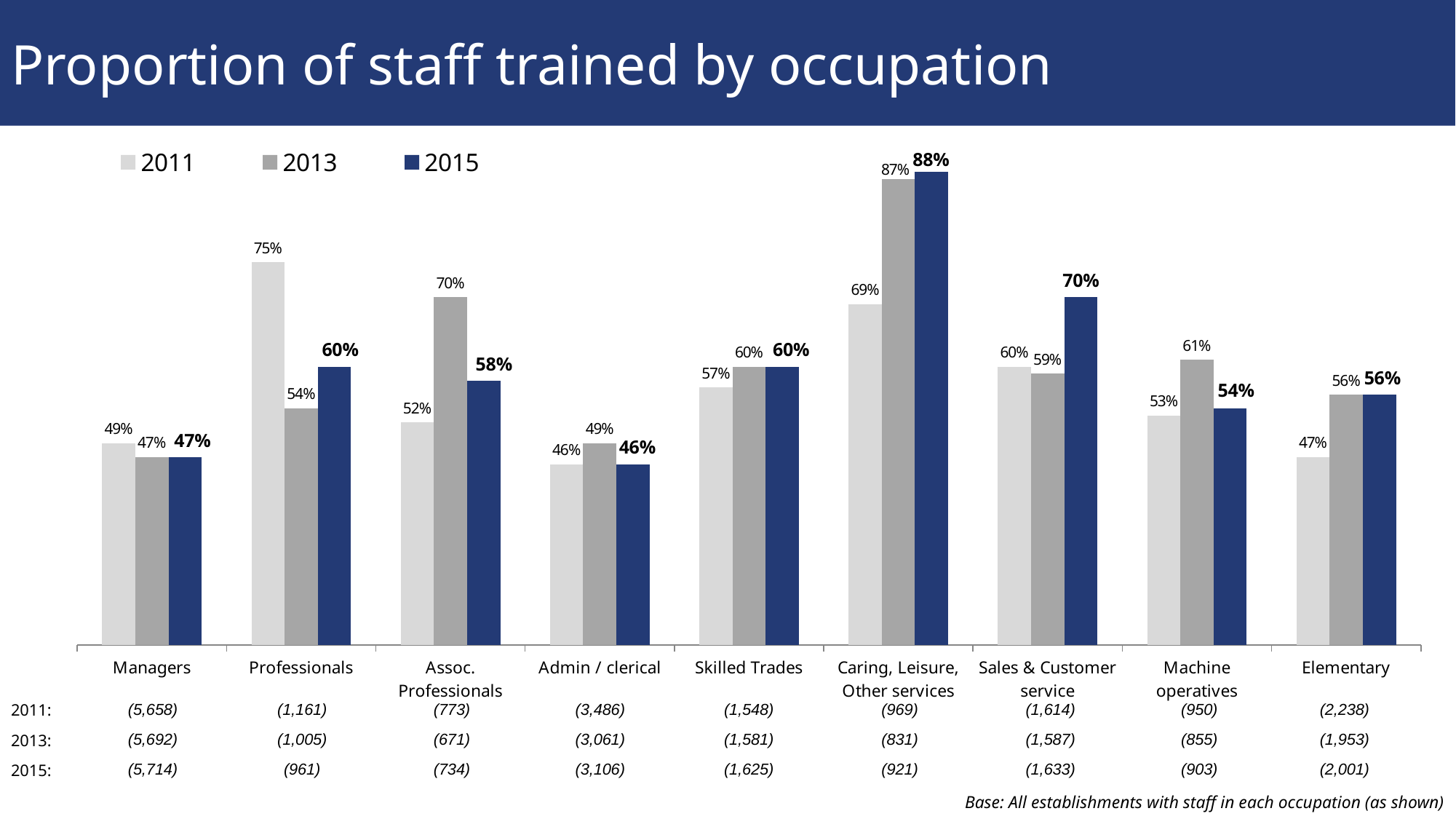
What is the 2013 value for Machine operatives? 61% What kind of chart is shown on the slide? Bar chart Which is larger for Assoc. Professionals: the 2013 value or the 2015 value? 2013 What is the 2011 value for Professionals? 75% What is the difference between the 2011 and 2015 values for Professionals? 15% Which occupation has the lowest 2015 value? Admin / clerical What is the title of the chart? Proportion of staff trained by occupation What is the 2015 value for Caring, Leisure, Other services? 88% How many occupation categories are shown on the x axis? 9 What is the difference between the 2013 and 2015 values for Sales & Customer service? 11% Which occupation has the highest 2015 value? Caring, Leisure, Other services How many series does the legend list? 3